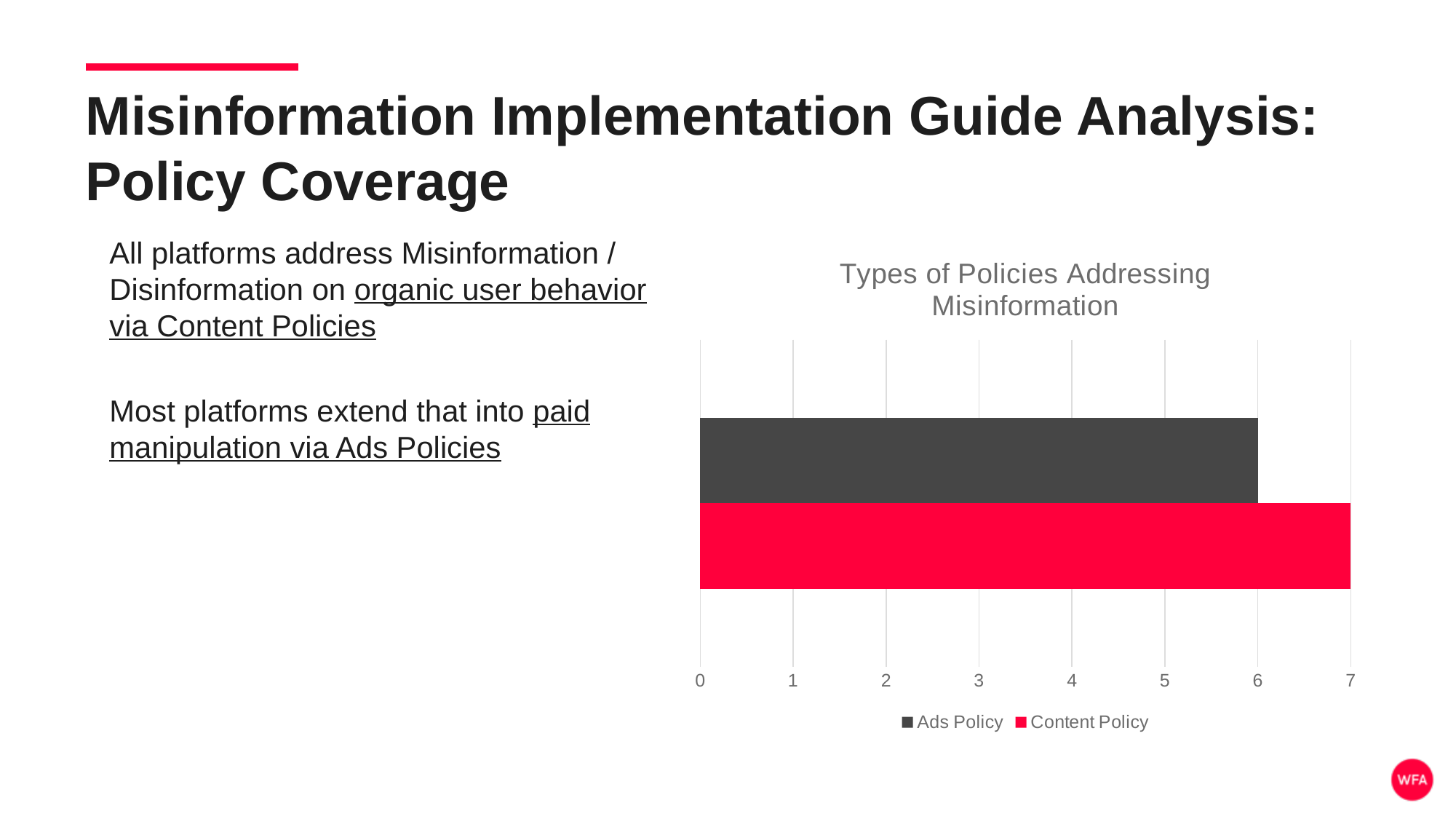
What value does the Content Policy bar reach on the axis? 7 Which series has the longer bar, Ads Policy or Content Policy? Content Policy Which series has the highest value in the chart? Content Policy Is the value for Ads Policy greater or less than 5? greater What is the title of the chart? Types of Policies Addressing Misinformation What value does the Ads Policy bar reach on the axis? 6 What is the difference between the Content Policy value and the Ads Policy value? 1 What is the maximum value shown on the horizontal axis? 7 What kind of chart is shown on the slide? bar chart How many series does the chart legend list? 2 Which series has the shortest bar in the chart? Ads Policy What colour is the Content Policy bar? red